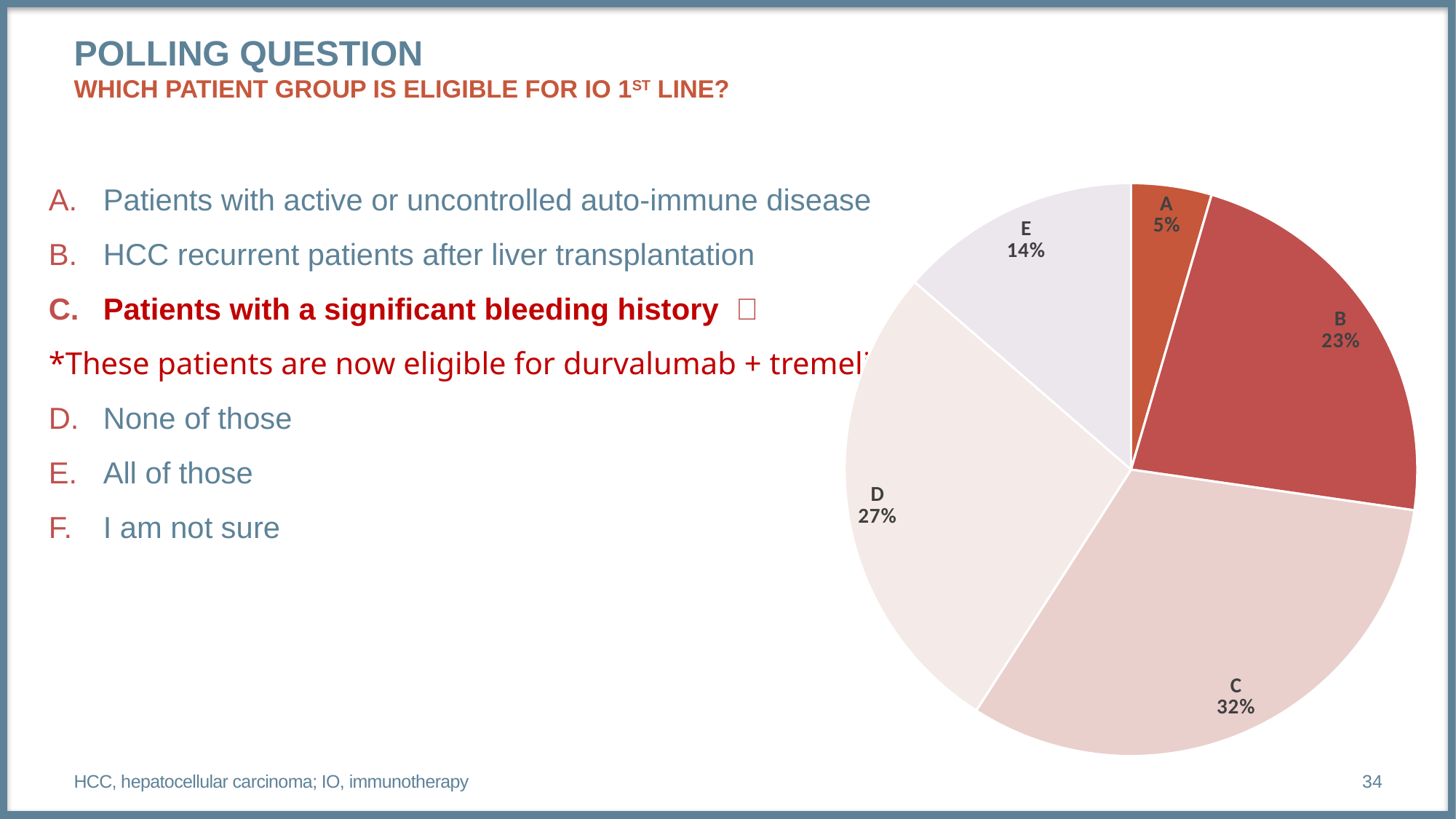
What percentage of responses does slice D represent? 27% Which slice of the pie chart is coloured the darkest red? B How many slices does the pie chart have? 5 What percentage of responses does slice C represent? 32% Which is larger, slice D or slice B? D Which slice of the pie chart is the largest? C What percentage of responses does slice A represent? 5% What is the difference in percentage points between slice C and slice B? 9 Which slice of the pie chart is the smallest? A What percentage of responses does slice E represent? 14% What is the combined percentage of slices A and E? 19% What kind of chart is shown on the slide? pie chart